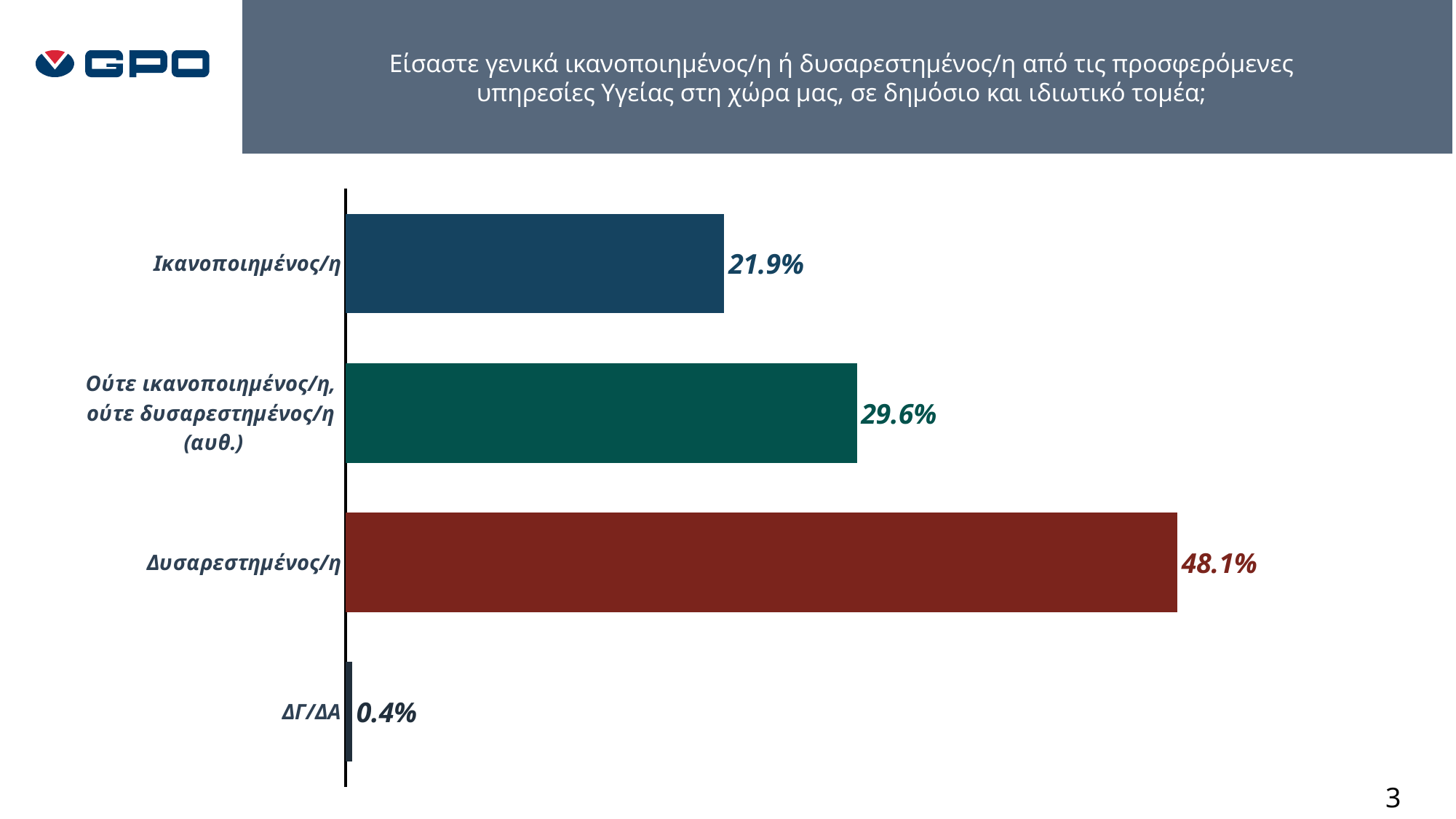
Which category has the highest value? Δυσαρεστημένος/η What is the value for Δυσαρεστημένος/η? 48.1% What is the value for Ικανοποιημένος/η? 21.9% What is the difference between the values for Ούτε ικανοποιημένος/η, ούτε δυσαρεστημένος/η (αυθ.) and Ικανοποιημένος/η? 7.7% What is the difference between the values for Δυσαρεστημένος/η and Ικανοποιημένος/η? 26.2% How many categories are shown in the chart? 4 What colour is the bar for Δυσαρεστημένος/η? Dark red What kind of chart is shown on the slide? Bar chart Which is larger, the value for Ικανοποιημένος/η or the value for Ούτε ικανοποιημένος/η, ούτε δυσαρεστημένος/η (αυθ.)? Ούτε ικανοποιημένος/η, ούτε δυσαρεστημένος/η (αυθ.) What is the value for Ούτε ικανοποιημένος/η, ούτε δυσαρεστημένος/η (αυθ.)? 29.6% What is the value for ΔΓ/ΔΑ? 0.4% Which category has the lowest value? ΔΓ/ΔΑ